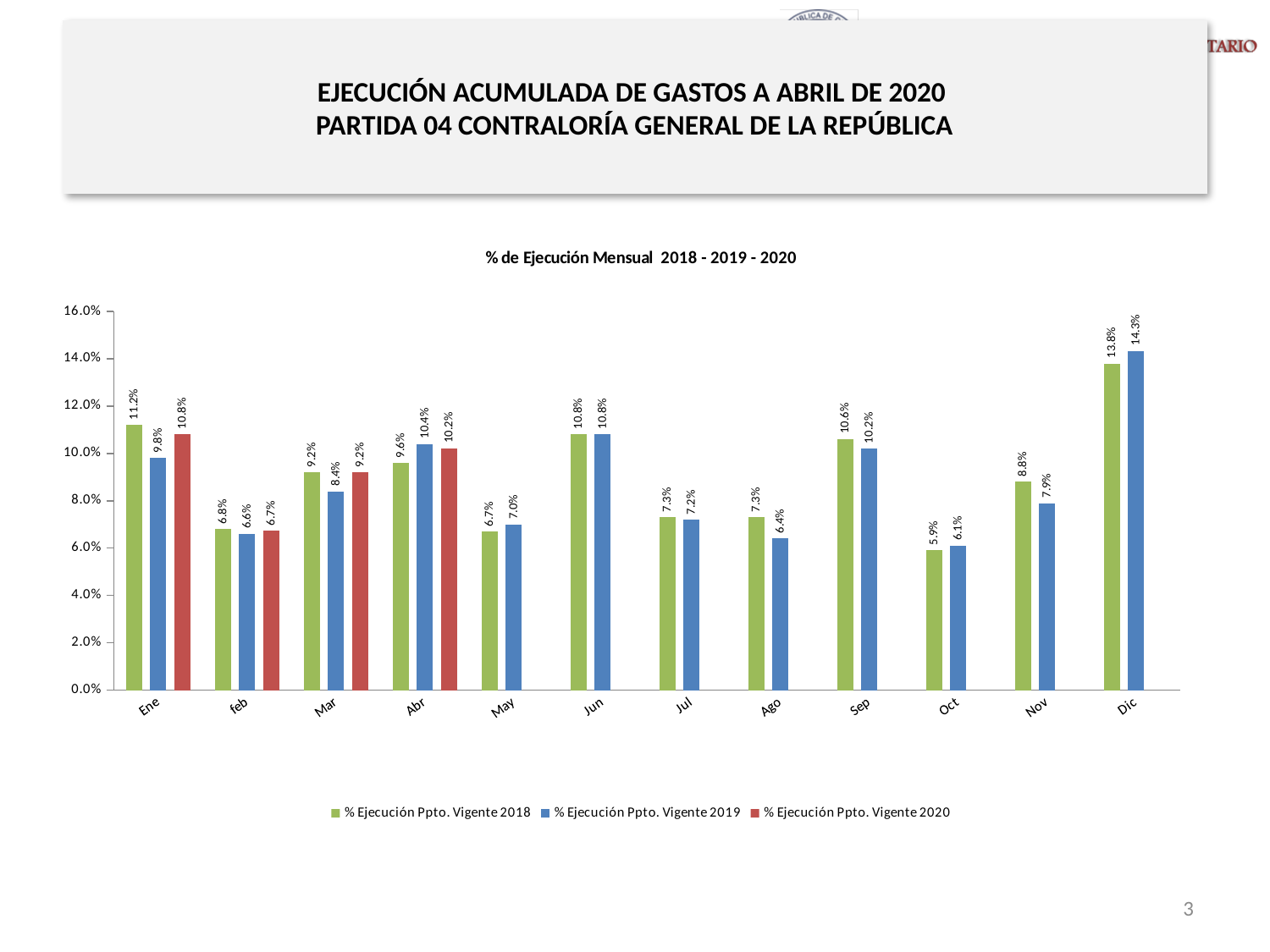
What is the difference between the 2019 and 2018 values in Dic? 0.5% Which is larger in Nov: the 2018 value or the 2019 value? 2018 What is the value for % Ejecución Ppto. Vigente 2018 in Dic? 13.8% What kind of chart is shown on the slide? Bar chart Which month has the highest value for % Ejecución Ppto. Vigente 2019? Dic What is the difference between the 2018 and 2019 values in Ene? 1.4% How many months have a bar for % Ejecución Ppto. Vigente 2020? 4 Which month has the lowest value for % Ejecución Ppto. Vigente 2018? Oct What is the value for % Ejecución Ppto. Vigente 2020 in Ene? 10.8% Is the value for % Ejecución Ppto. Vigente 2019 in Dic greater or less than 14.0%? greater How many series does the legend list? 3 What is the value for % Ejecución Ppto. Vigente 2019 in Abr? 10.4%